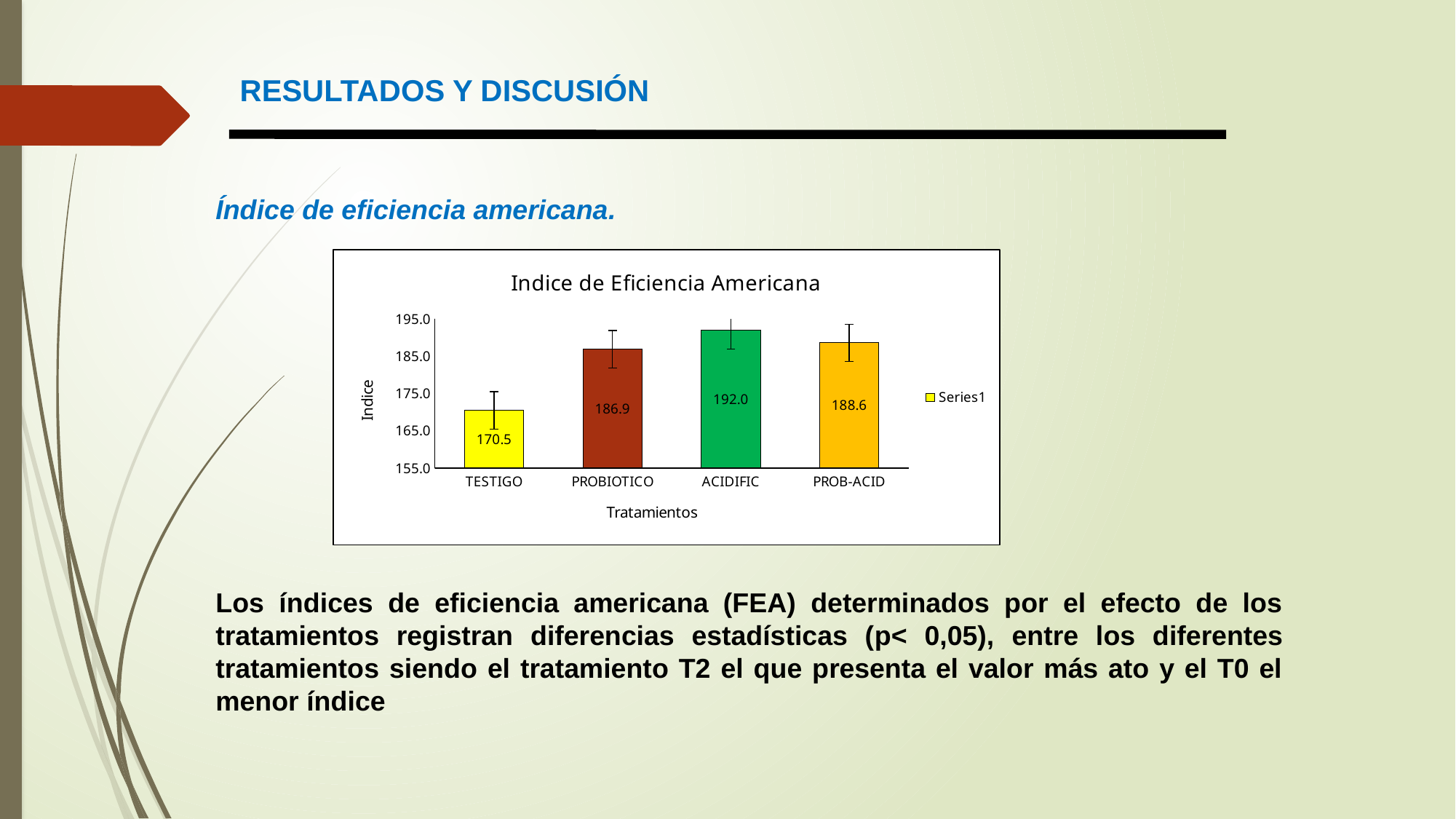
What kind of chart is shown? bar chart What is the value for ACIDIFIC? 192.0 What is the title of the chart? Indice de Eficiencia Americana What is the value for PROB-ACID? 188.6 Which treatment has the highest index value? ACIDIFIC Which treatment has the lowest index value? TESTIGO How many treatments are shown on the x axis? 4 What is the value for TESTIGO? 170.5 Which is larger, the value for PROBIOTICO or the value for PROB-ACID? PROB-ACID What is the value for PROBIOTICO? 186.9 What is the difference between the values for ACIDIFIC and TESTIGO? 21.5 Is the value for TESTIGO greater or less than 175.0? less